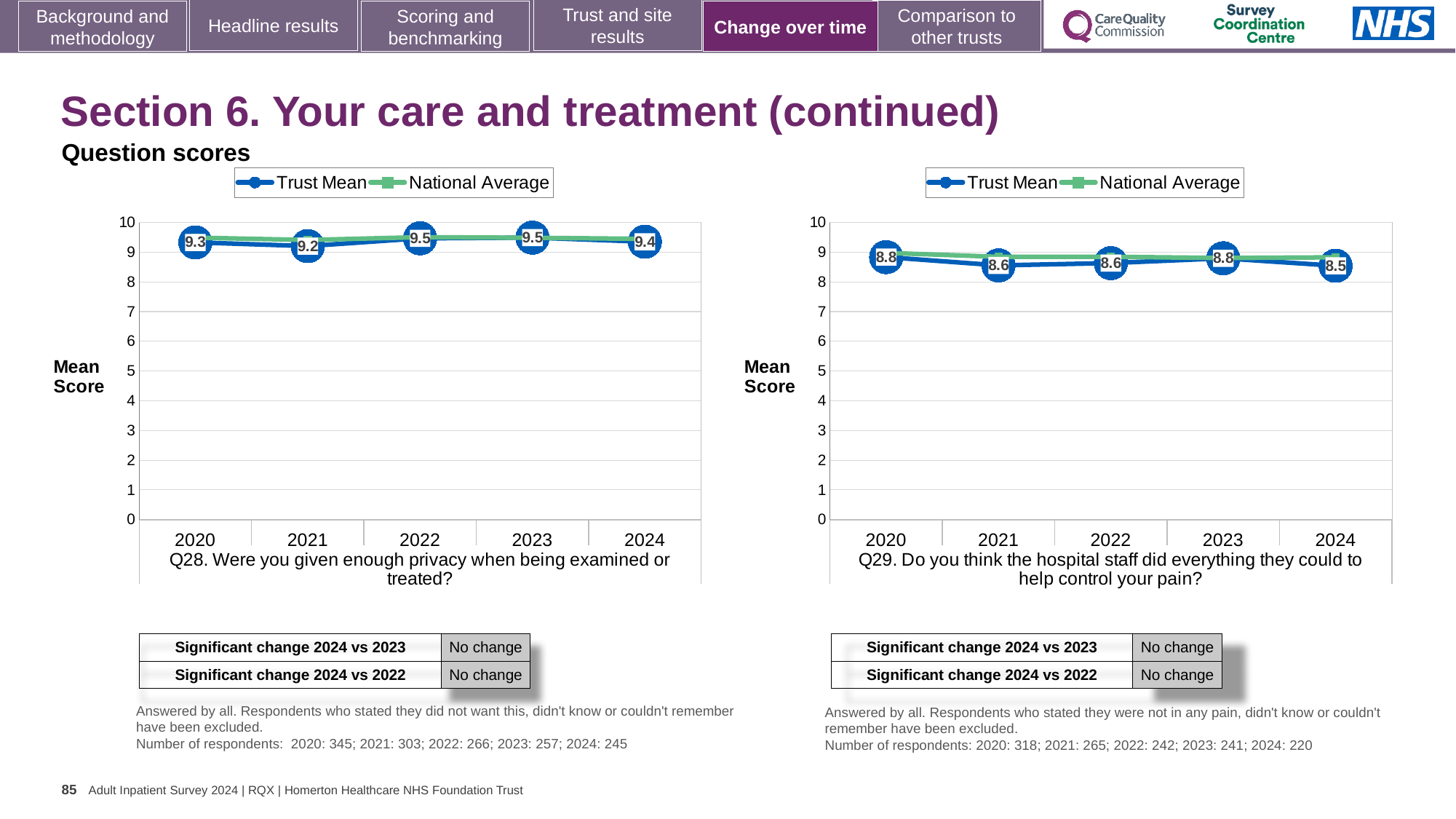
In the Q29 chart on the right, which year has the lowest Trust Mean score? 2024 In the Q29 chart on the right, what is the Trust Mean score for 2024? 8.5 In the Q28 chart on the left, what is the difference between the Trust Mean scores for 2022 and 2021? 0.3 How many years are shown on the x axis of the Q28 chart on the left? 5 In the Q29 chart on the right, what is the difference between the Trust Mean scores for 2020 and 2024? 0.3 What kind of chart is the Q28 chart on the left? Line chart How many series does the legend of the Q29 chart on the right list? 2 In the Q29 chart on the right, is the National Average value for 2024 greater or less than 8? greater In the Q28 chart on the left, which year has the lowest Trust Mean score? 2021 In the Q28 chart on the left, what is the Trust Mean score for 2022? 9.5 In the Q29 chart on the right, is the Trust Mean score higher in 2023 or 2024? 2023 In the Q29 chart on the right, does the Trust Mean score rise or fall from 2023 to 2024? Fall